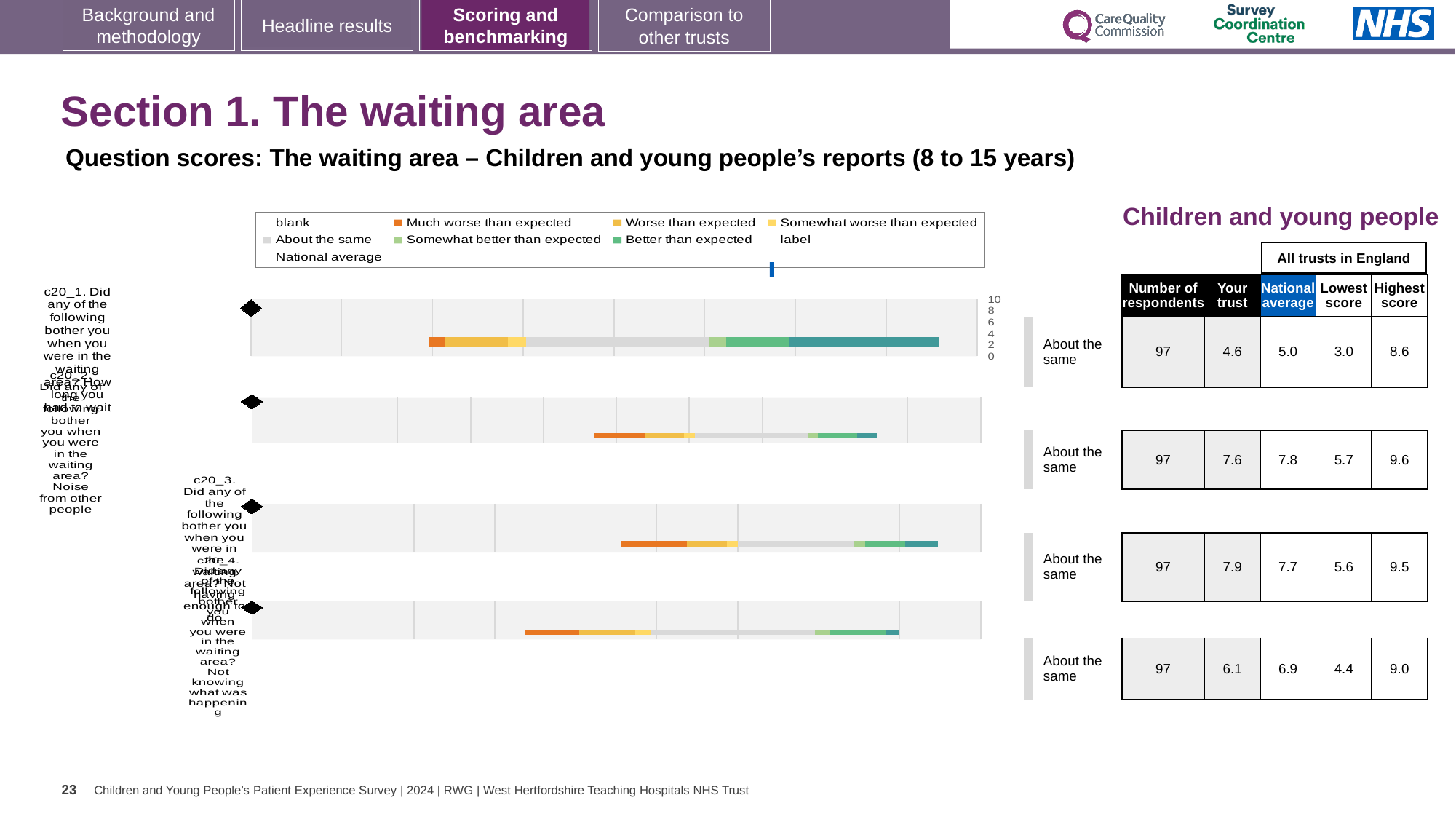
What is the highest tick value shown on the axis of the first chart? 10 How many separate bar charts are shown on the slide? 4 How many entries does the legend above the charts list? 9 What is the question code of the third chart's category label? c20_3 What benchmark label is shown to the right of each of the four charts? About the same Which legend entry is shown in orange? Much worse than expected What kind of chart is used to show the question scores on this slide? bar chart What is the question code of the first (top) chart's category label? c20_1